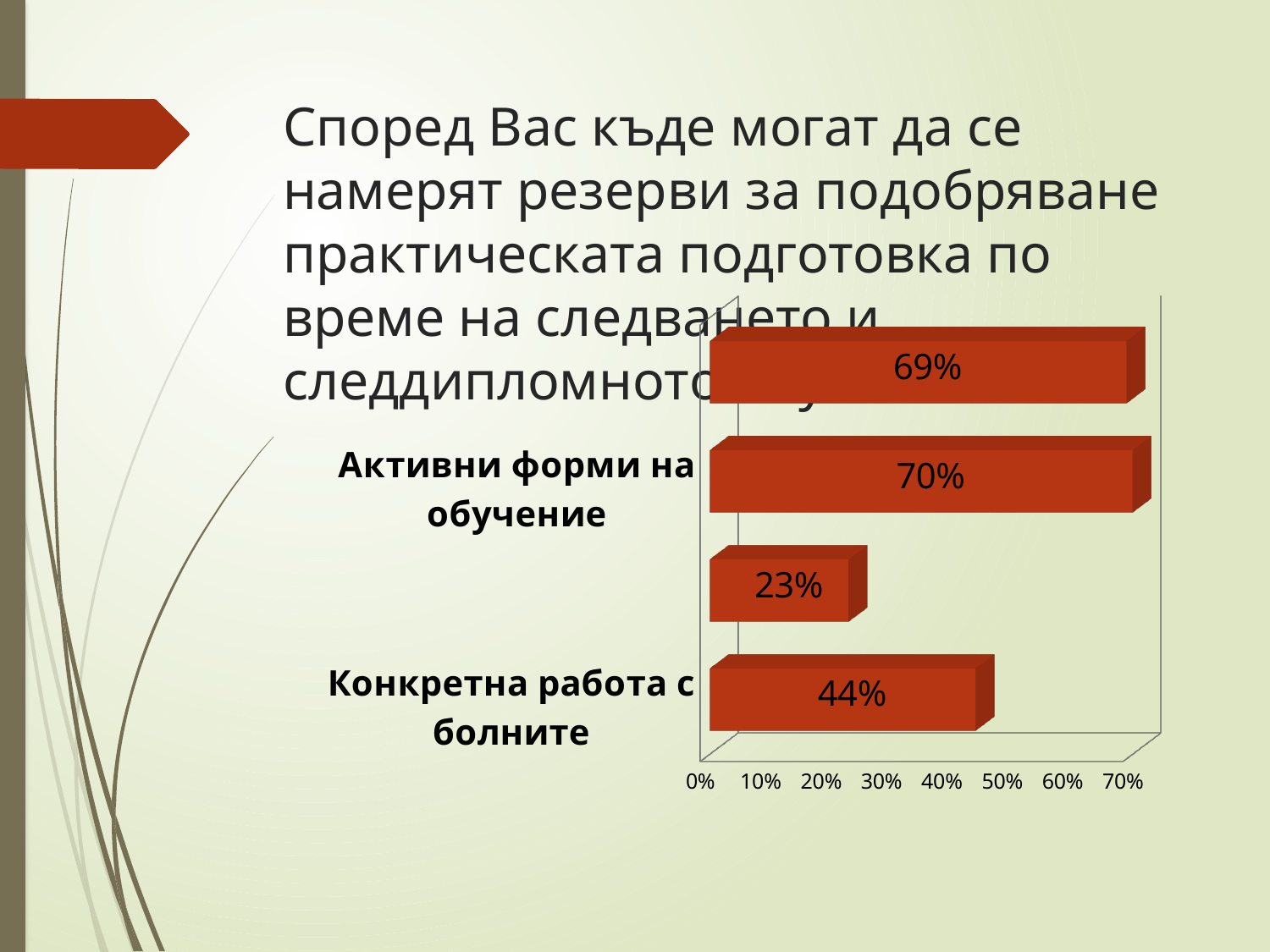
How many bars are plotted in the chart? 4 What is the highest tick label shown on the horizontal axis? 70% What is the value for "Активни форми на обучение"? 70% What is the lowest value shown on any bar in the chart? 23% What is the highest value shown on any bar in the chart? 70% What colour are the bars in the chart? red What is the difference between the values for "Активни форми на обучение" and "Конкретна работа с болните"? 26% Is the value for "Конкретна работа с болните" greater or less than 40%? greater Which is larger: the value for "Активни форми на обучение" or the value for "Конкретна работа с болните"? Активни форми на обучение What is the value for "Конкретна работа с болните"? 44% Is the value for "Активни форми на обучение" greater or less than 60%? greater What kind of chart is shown on the slide? bar chart